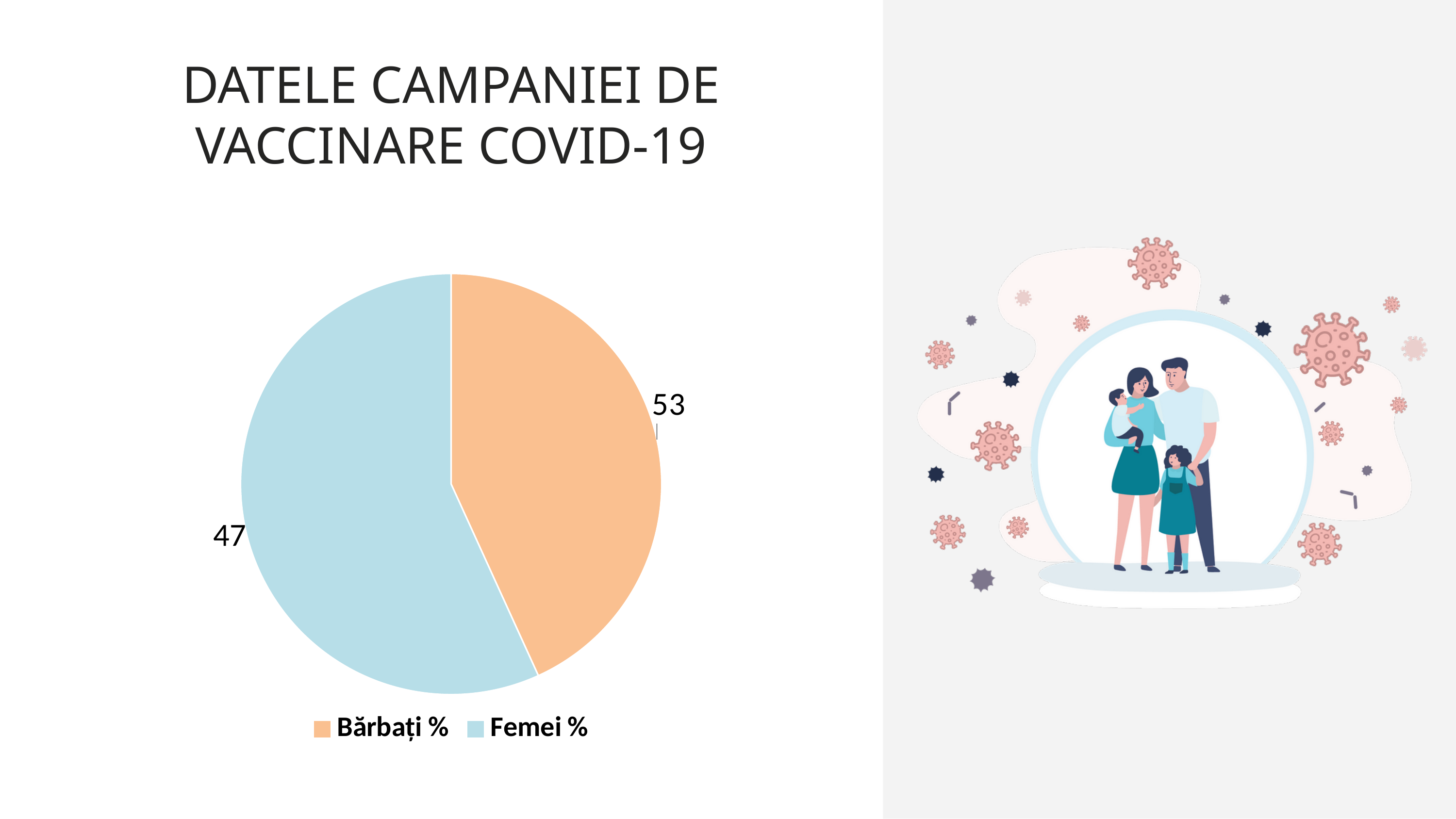
What colour is the Bărbați % slice? orange What share of the pie does the Femei % slice represent? 47% What is the value for Bărbați %? 53 Which slice is the largest? Femei % Which is larger, Bărbați % or Femei %? Femei % What kind of chart is shown on the slide? pie chart What is the value for Femei %? 47 How many entries does the legend list? 2 Which slice is the smallest? Bărbați % What is the title shown above the chart? DATELE CAMPANIEI DE VACCINARE COVID-19 How many slices does the pie chart have? 2 What is the difference between the Bărbați % and Femei % values? 6